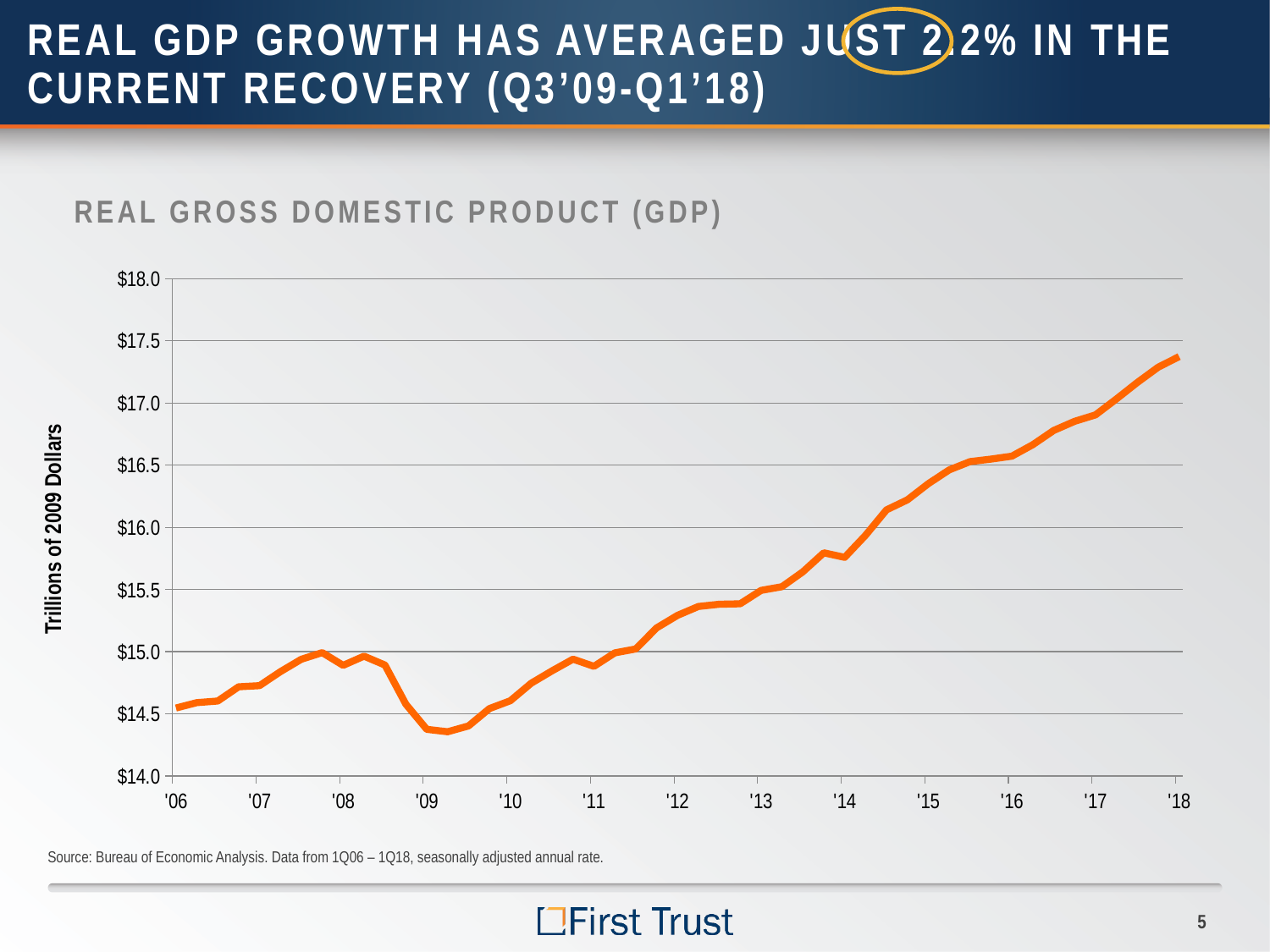
Which year label on the x axis has the highest value? '18 Is the value at '09 greater or less than $14.5? less What is the label on the vertical axis of the chart? Trillions of 2009 Dollars Is the value at '18 greater or less than $17.0? greater What kind of chart is shown on the slide? line chart Is the value at '14 greater or less than $15.5? greater What is the title of the chart? REAL GROSS DOMESTIC PRODUCT (GDP) Which is larger, the value at '08 or the value at '09? '08 How many year labels are shown on the x axis? 13 Overall, do the values rise or fall from '06 to '18? rise